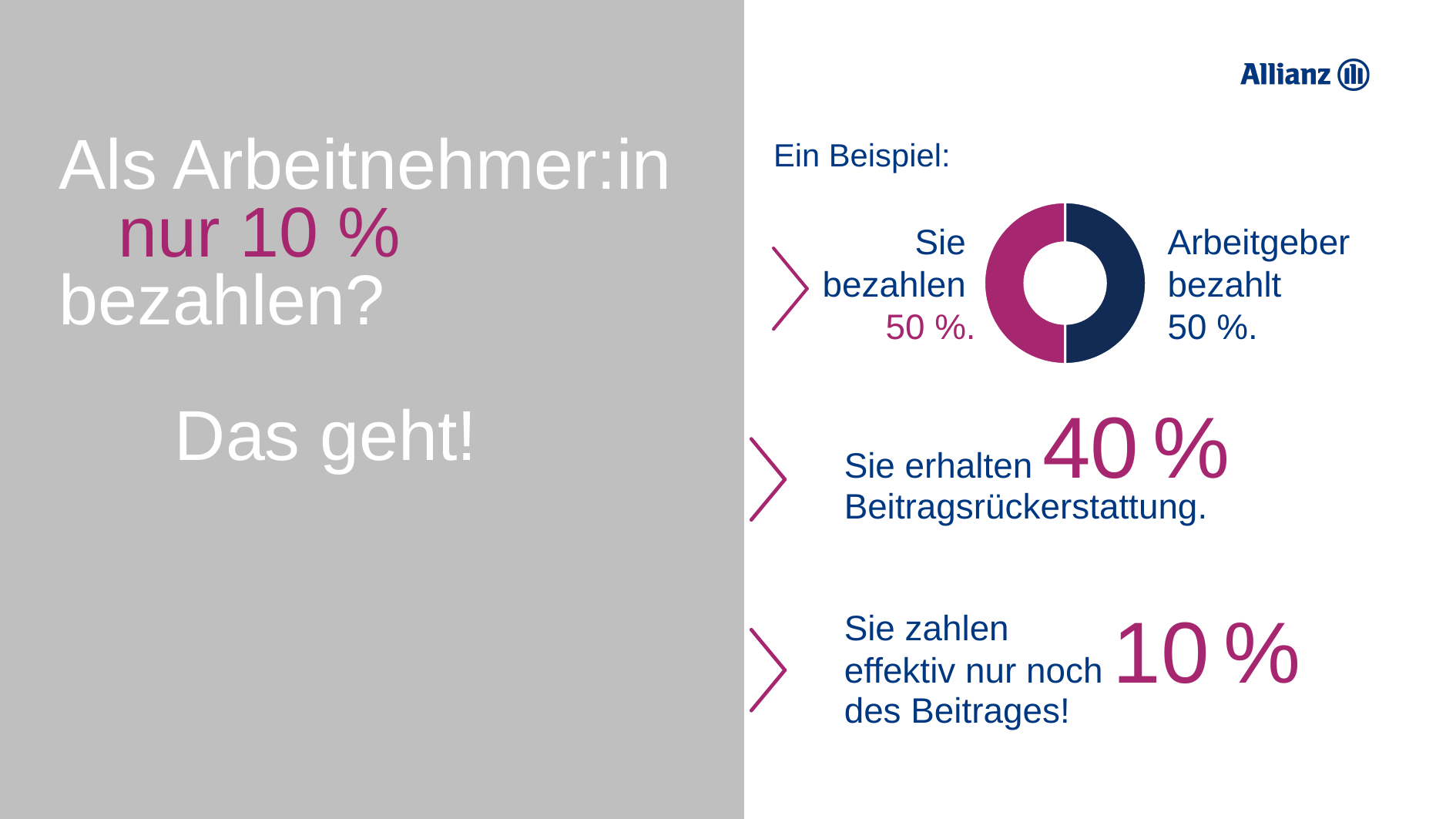
What value is shown for "Sie bezahlen" in the donut chart? 50 % Which colour represents the "Arbeitgeber bezahlt" slice in the donut chart? Dark blue What share of the donut chart is labelled "Arbeitgeber bezahlt"? 50 % How many slices does the donut chart have? 2 What is the difference between the "Sie bezahlen" share and the "Arbeitgeber bezahlt" share in the donut chart? 0 % What value is shown for "Arbeitgeber bezahlt" in the donut chart? 50 % What is the total of the two slices in the donut chart? 100 % Which colour represents the "Sie bezahlen" slice in the donut chart? Magenta What kind of chart is shown on the slide? Donut (pie) chart What share of the donut chart is labelled "Sie bezahlen"? 50 % Are the two slices of the donut chart equal in size? Yes